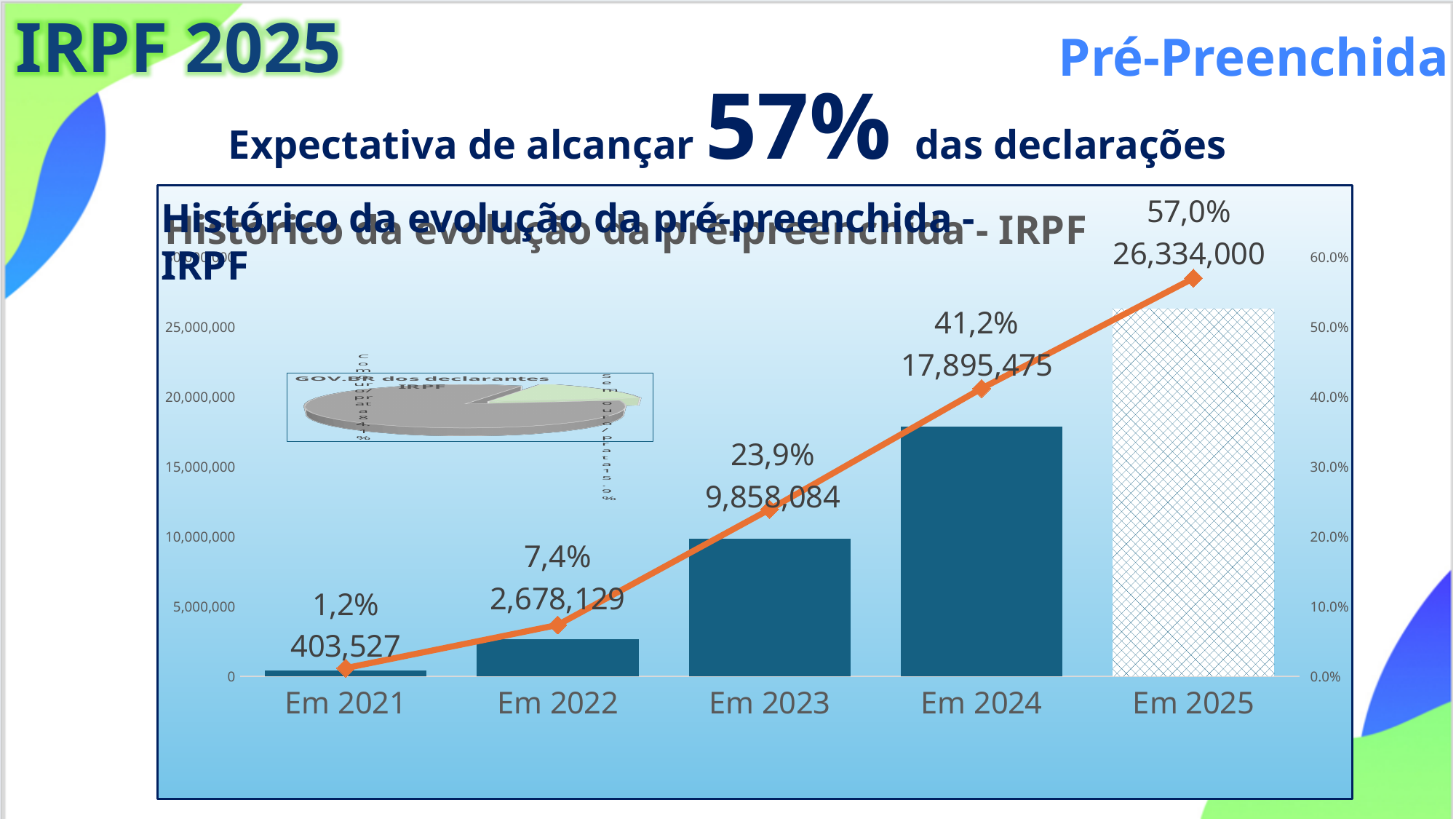
In the chart 'Histórico da evolução da pré-preenchida - IRPF', what is the difference in percentage points between Em 2024 and Em 2023? 17,3 In the chart 'Histórico da evolução da pré-preenchida - IRPF', which year has the lowest percentage? Em 2021 In the chart 'Histórico da evolução da pré-preenchida - IRPF', what is the difference between the number of declarations for Em 2025 and Em 2024? 8,438,525 In the chart 'Histórico da evolução da pré-preenchida - IRPF', what is the number of declarations shown for Em 2021? 403,527 In the chart 'Histórico da evolução da pré-preenchida - IRPF', which is larger: the number of declarations for Em 2022 or Em 2023? Em 2023 In the chart 'Histórico da evolução da pré-preenchida - IRPF', what is the number of declarations shown for Em 2023? 9,858,084 In the chart 'Histórico da evolução da pré-preenchida - IRPF', do the values rise or fall from Em 2021 to Em 2025? rise What is the title of the main chart on the slide? Histórico da evolução da pré-preenchida - IRPF In the chart 'Histórico da evolução da pré-preenchida - IRPF', what percentage is shown for Em 2022? 7,4% In the chart 'Histórico da evolução da pré-preenchida - IRPF', how many years are shown on the x axis? 5 In the chart 'Histórico da evolução da pré-preenchida - IRPF', what percentage is shown for Em 2024? 41,2% In the chart 'Histórico da evolução da pré-preenchida - IRPF', which year has the highest number of declarations? Em 2025